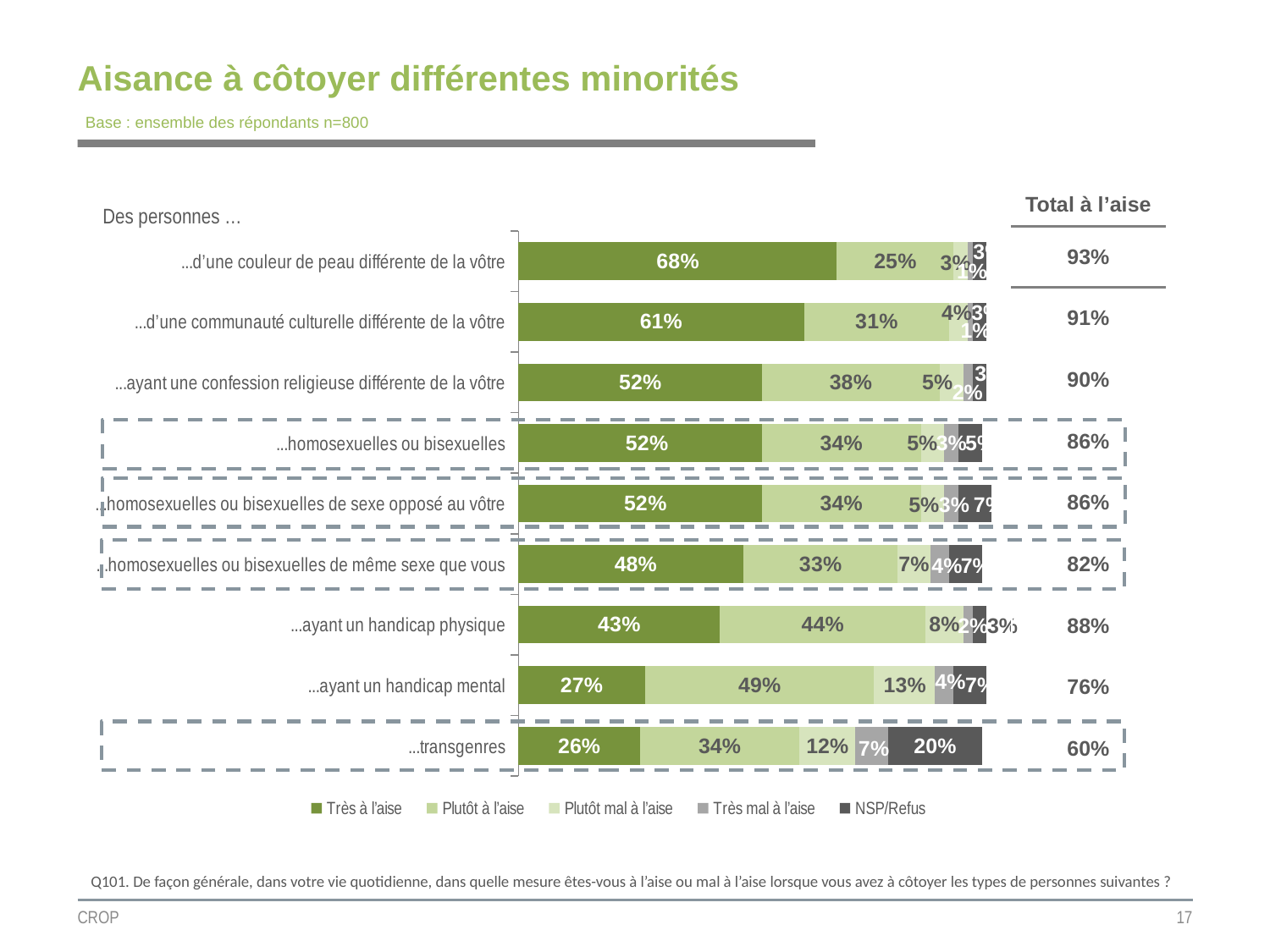
What is the 'Total à l'aise' value for people 'ayant un handicap mental'? 76% What is the difference in 'Très à l'aise' between 'd'une couleur de peau différente de la vôtre' and 'd'une communauté culturelle différente de la vôtre'? 7 percentage points Which is larger: the 'Très à l'aise' value for 'ayant une confession religieuse différente de la vôtre' or for 'ayant un handicap physique'? ayant une confession religieuse différente de la vôtre What is the title of the chart slide? Aisance à côtoyer différentes minorités What kind of chart is shown on the slide? Stacked bar chart Which category has the lowest 'Total à l'aise' value? ...transgenres What percentage of respondents are 'Très à l'aise' with people 'd'une couleur de peau différente de la vôtre'? 68% How many categories of people are plotted in the chart? 9 Which category has the highest 'Très à l'aise' value? ...d'une couleur de peau différente de la vôtre What is the 'Plutôt à l'aise' value for people 'ayant un handicap mental'? 49% What is the 'NSP/Refus' value for people '...transgenres'? 20% How many series does the legend list? 5